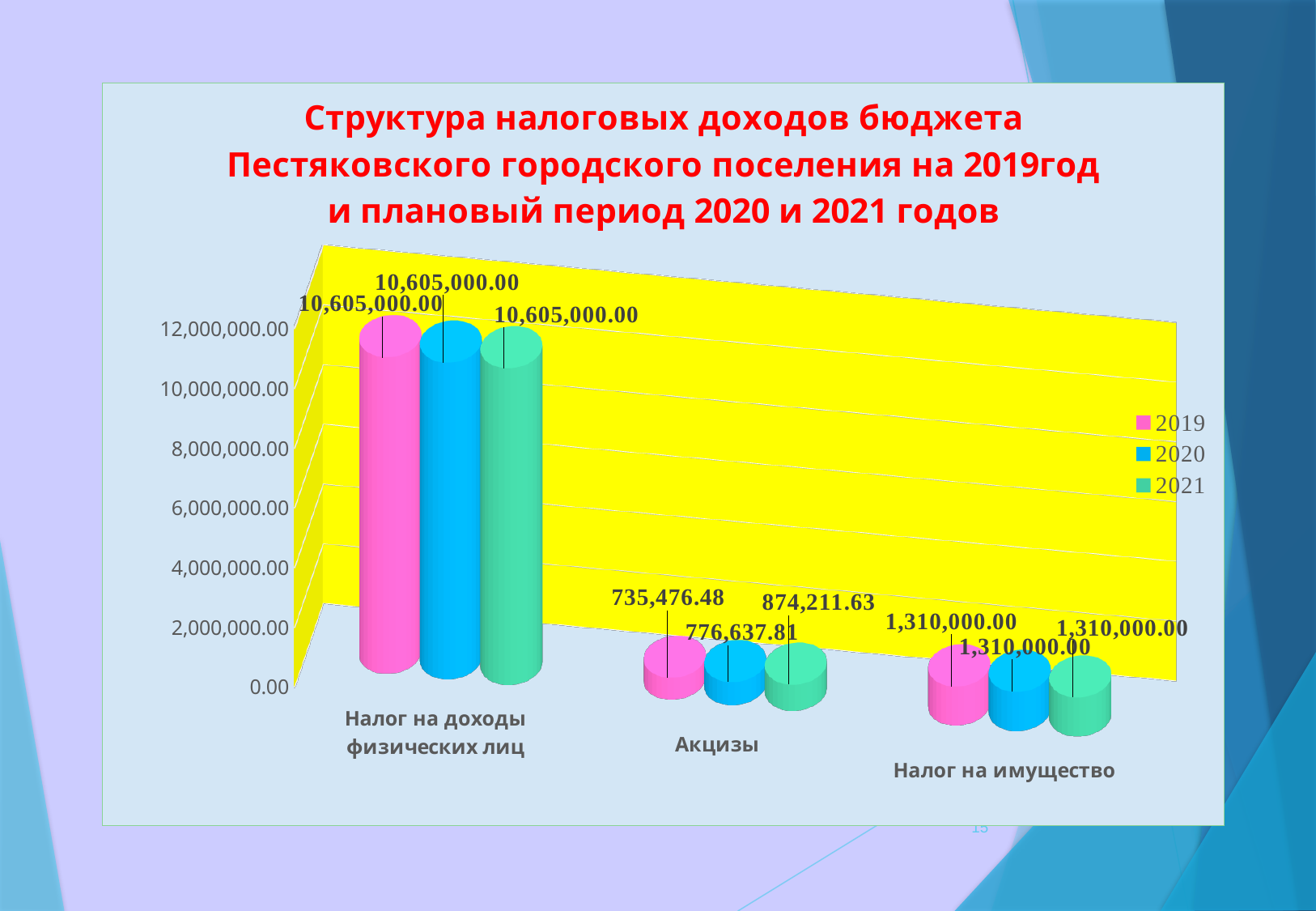
What is the difference between the 2021 and 2019 values for Акцизы? 138,735.15 How many series does the legend list? 3 Do the values for Акцизы rise or fall from 2019 to 2021? rise Which category has the highest value in 2019? Налог на доходы физических лиц What is the value for Налог на доходы физических лиц in 2020? 10,605,000.00 What is the value for Акцизы in 2019? 735,476.48 Which category has the lowest value in 2020? Акцизы Is the value for Налог на доходы физических лиц in 2021 greater or less than 10,000,000.00? greater What is the value for Налог на имущество in 2021? 1,310,000.00 What is the value for Акцизы in 2021? 874,211.63 Which is larger: the 2020 value for Акцизы or the 2020 value for Налог на имущество? Налог на имущество How many categories are shown on the x axis? 3